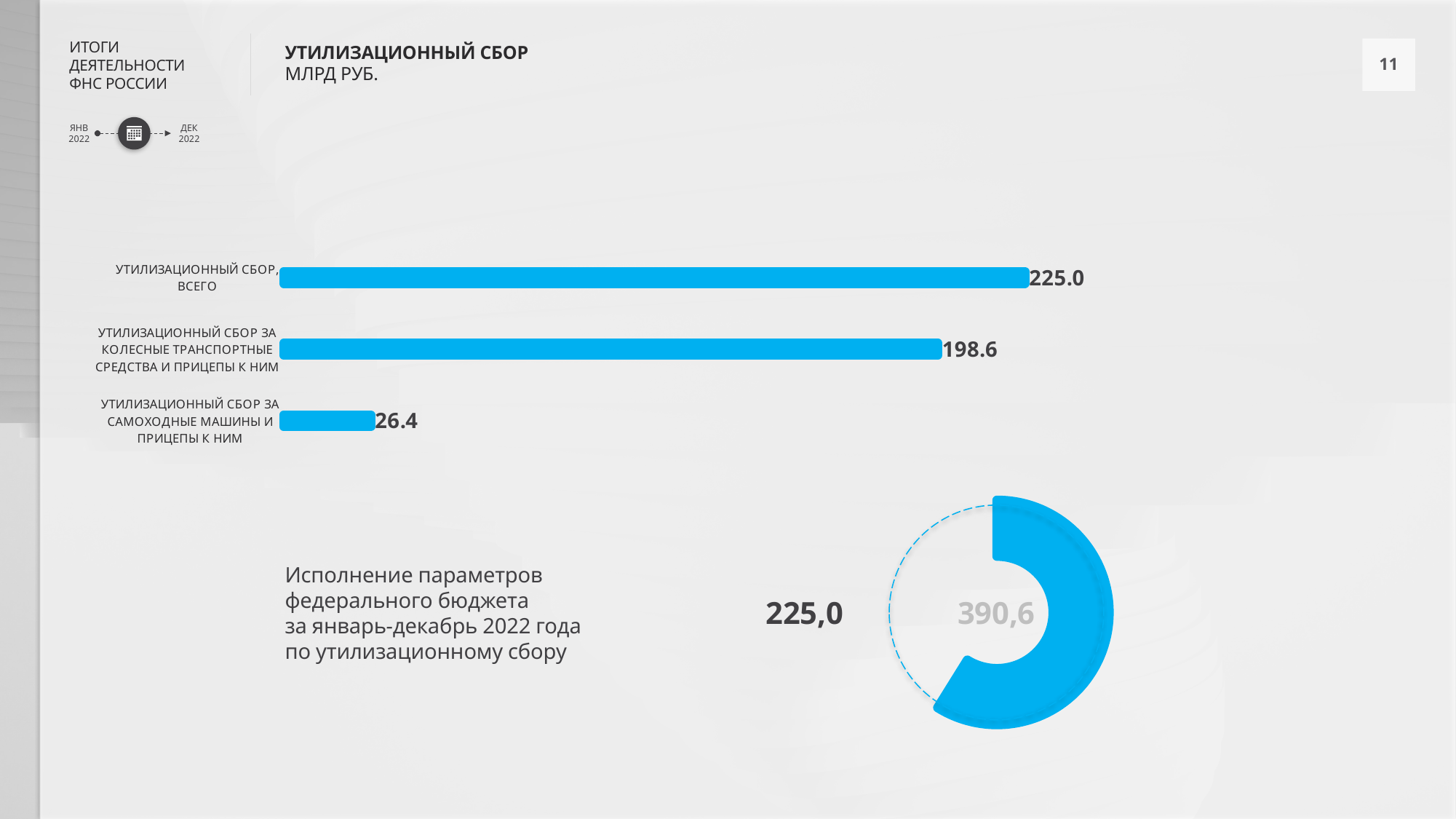
What kind of chart is the chart at the top of the slide? bar chart In the bar chart, what is the value for УТИЛИЗАЦИОННЫЙ СБОР ЗА КОЛЕСНЫЕ ТРАНСПОРТНЫЕ СРЕДСТВА И ПРИЦЕПЫ К НИМ? 198.6 In the donut chart at the bottom of the slide, what value is printed in the centre of the ring? 390,6 How many categories does the bar chart show? 3 In the bar chart, what is the value for УТИЛИЗАЦИОННЫЙ СБОР ЗА САМОХОДНЫЕ МАШИНЫ И ПРИЦЕПЫ К НИМ? 26.4 In the bar chart, which category has the lowest value? УТИЛИЗАЦИОННЫЙ СБОР ЗА САМОХОДНЫЕ МАШИНЫ И ПРИЦЕПЫ К НИМ In the bar chart, what is the difference between the value for УТИЛИЗАЦИОННЫЙ СБОР, ВСЕГО and the value for УТИЛИЗАЦИОННЫЙ СБОР ЗА КОЛЕСНЫЕ ТРАНСПОРТНЫЕ СРЕДСТВА И ПРИЦЕПЫ К НИМ? 26.4 In the bar chart, which category has the highest value? УТИЛИЗАЦИОННЫЙ СБОР, ВСЕГО In the donut chart at the bottom of the slide, what value is printed to the left of the ring? 225,0 In the bar chart, which is larger: the value for КОЛЕСНЫЕ ТРАНСПОРТНЫЕ СРЕДСТВА И ПРИЦЕПЫ К НИМ or the value for САМОХОДНЫЕ МАШИНЫ И ПРИЦЕПЫ К НИМ? КОЛЕСНЫЕ ТРАНСПОРТНЫЕ СРЕДСТВА И ПРИЦЕПЫ К НИМ In the bar chart, what is the value for УТИЛИЗАЦИОННЫЙ СБОР, ВСЕГО? 225.0 In the bar chart, what is the difference between the value for КОЛЕСНЫЕ ТРАНСПОРТНЫЕ СРЕДСТВА И ПРИЦЕПЫ К НИМ and the value for САМОХОДНЫЕ МАШИНЫ И ПРИЦЕПЫ К НИМ? 172.2